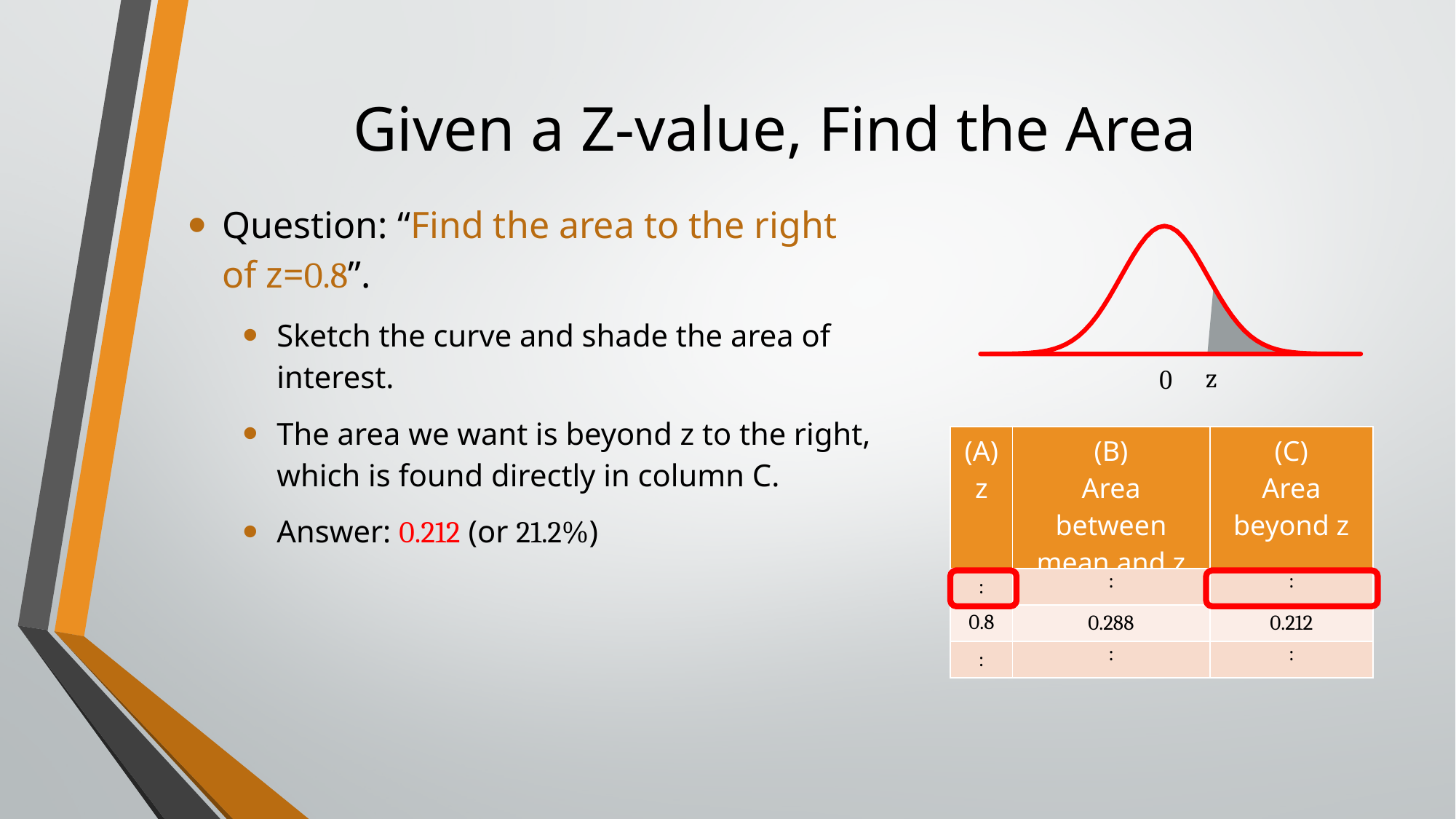
How many labelled columns does the table have? 3 What kind of chart is shown at the top right of the slide? A bell-shaped normal distribution curve In the table, what is the value in column (C) Area beyond z for z = 0.8? 0.212 In the table, what is the difference between the area between mean and z and the area beyond z for z = 0.8? 0.076 In the curve at the top right, which region is shaded grey? The area to the right of z (beyond z) What two labels appear on the horizontal axis of the curve at the top right? 0 and z In the table, which is larger for z = 0.8: the area between mean and z, or the area beyond z? Area between mean and z In the table, what is the sum of the area between mean and z and the area beyond z for z = 0.8? 0.500 In the table, what is the value in column (B) Area between mean and z for z = 0.8? 0.288 Which column of the table is highlighted with a red outline alongside column (A)? Column (C) Area beyond z